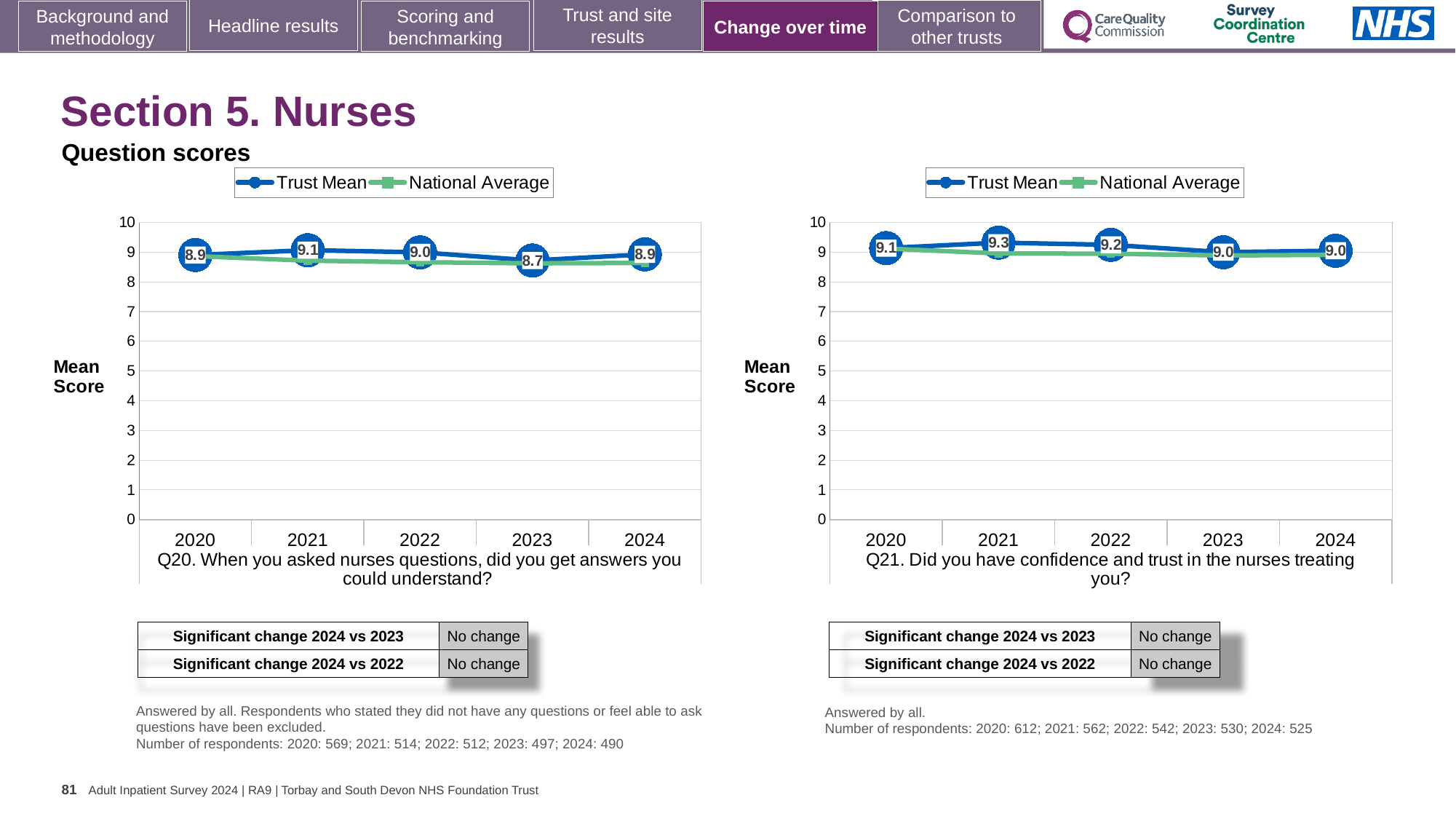
How many series does the legend of the Q20 chart (left) list? 2 In the Q21 chart (right), is the Trust Mean score for 2021 larger or smaller than the score for 2023? larger How many years are shown on the x axis of the Q21 chart (right)? 5 In the Q20 chart (left), what is the Trust Mean score for 2023? 8.7 In the Q20 chart (left), what is the Trust Mean score for 2021? 9.1 In the Q20 chart (left), what is the difference between the Trust Mean scores for 2021 and 2023? 0.4 In the Q20 chart (left), which year has the lowest Trust Mean score? 2023 What type of chart is used for Q21 (right)? Line chart In the Q21 chart (right), what is the Trust Mean score for 2022? 9.2 In the Q20 chart (left), is the National Average value for 2024 greater or less than 8? greater In the Q21 chart (right), which year has the highest Trust Mean score? 2021 In the Q21 chart (right), what is the Trust Mean score for 2020? 9.1